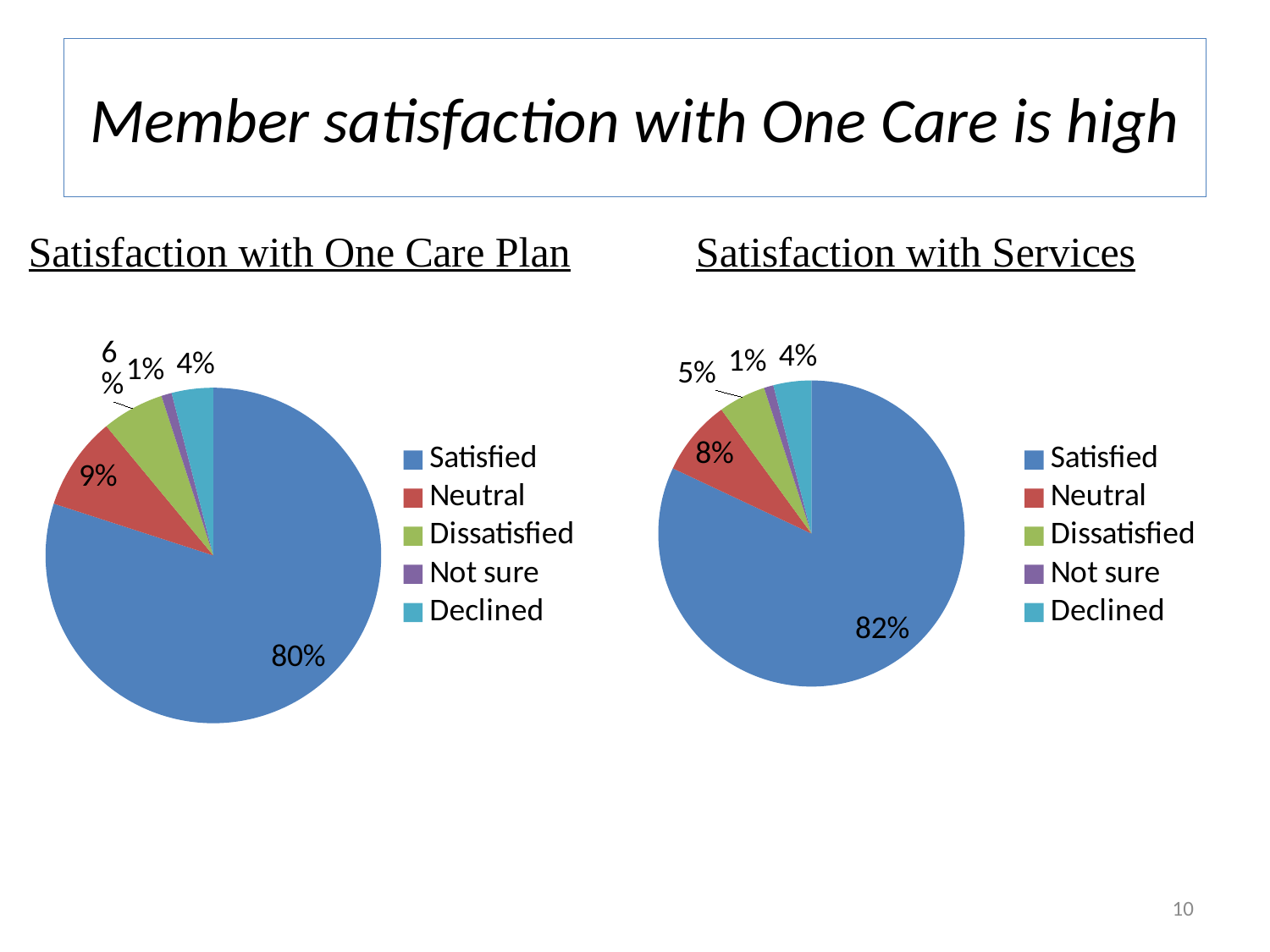
In the 'Satisfaction with One Care Plan' chart, which category has the smallest share? Not sure What is the difference between the Satisfied share in the 'Satisfaction with Services' chart and the Satisfied share in the 'Satisfaction with One Care Plan' chart? 2% In the 'Satisfaction with One Care Plan' chart, which is larger: Neutral or Dissatisfied? Neutral What kind of chart is the 'Satisfaction with One Care Plan' chart? Pie chart In the 'Satisfaction with Services' chart, what percentage of members are Satisfied? 82% In the 'Satisfaction with Services' chart, which category has the largest share? Satisfied In the 'Satisfaction with One Care Plan' chart, what percentage of members are Satisfied? 80% In the 'Satisfaction with Services' chart, what is the value for Dissatisfied? 5% In the 'Satisfaction with One Care Plan' chart, what is the value for Neutral? 9% In the 'Satisfaction with Services' chart, what is the value for Declined? 4% How many categories does the legend of the 'Satisfaction with Services' chart list? 5 In the 'Satisfaction with Services' chart, what colour is the Satisfied slice? Blue